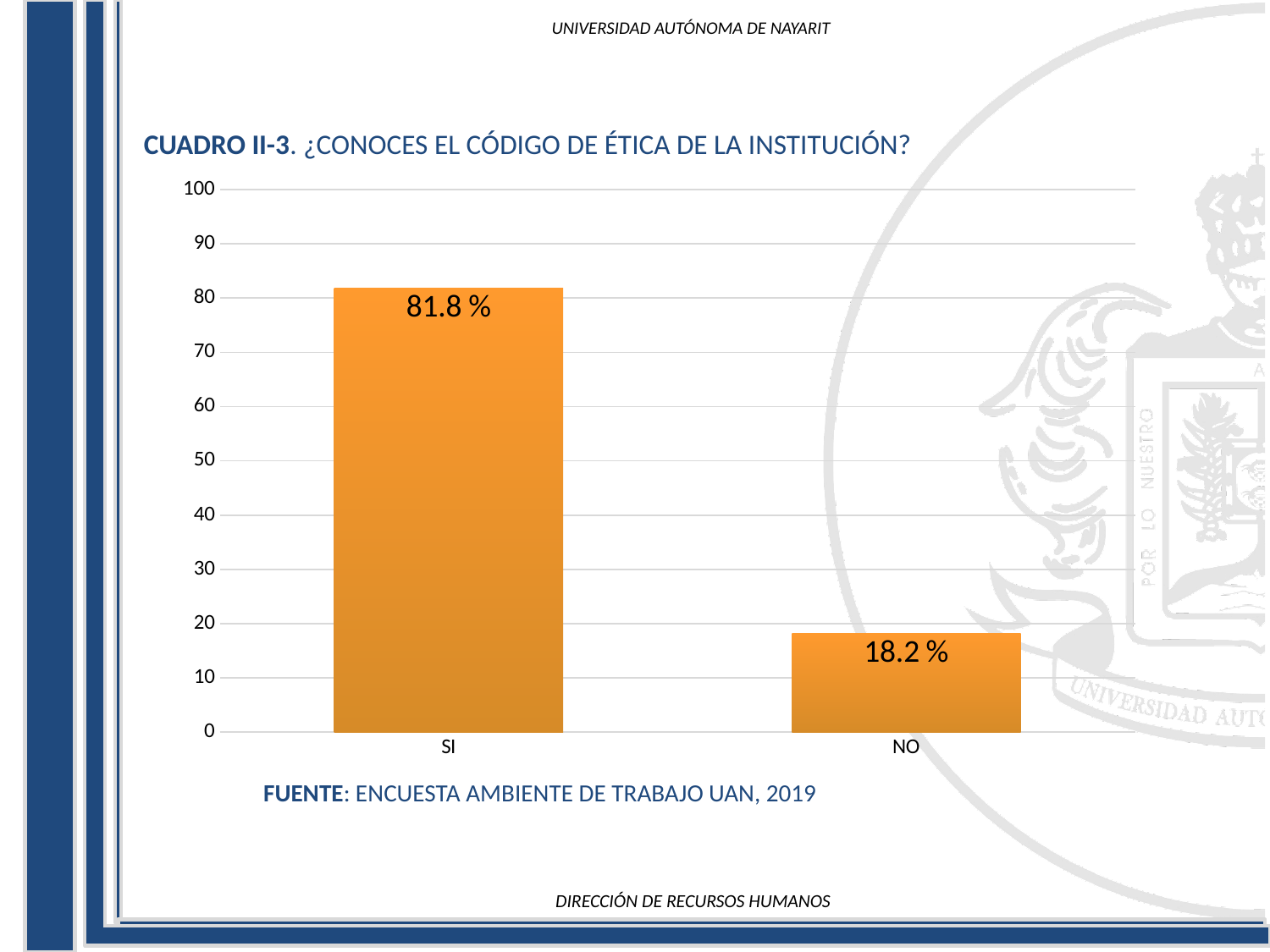
What is the source cited below the chart? ENCUESTA AMBIENTE DE TRABAJO UAN, 2019 What is the value for NO? 18.2 % What kind of chart is shown on the slide? bar chart Which category has the highest value? SI What is the difference between the values for SI and NO? 63.6 % What is the title of the chart? CUADRO II-3. ¿CONOCES EL CÓDIGO DE ÉTICA DE LA INSTITUCIÓN? Which is larger, the value for SI or the value for NO? SI Is the value for NO greater or less than 20? less Is the value for SI greater or less than 80? greater Which category has the lowest value? NO How many categories are shown on the x axis? 2 What is the value for SI? 81.8 %